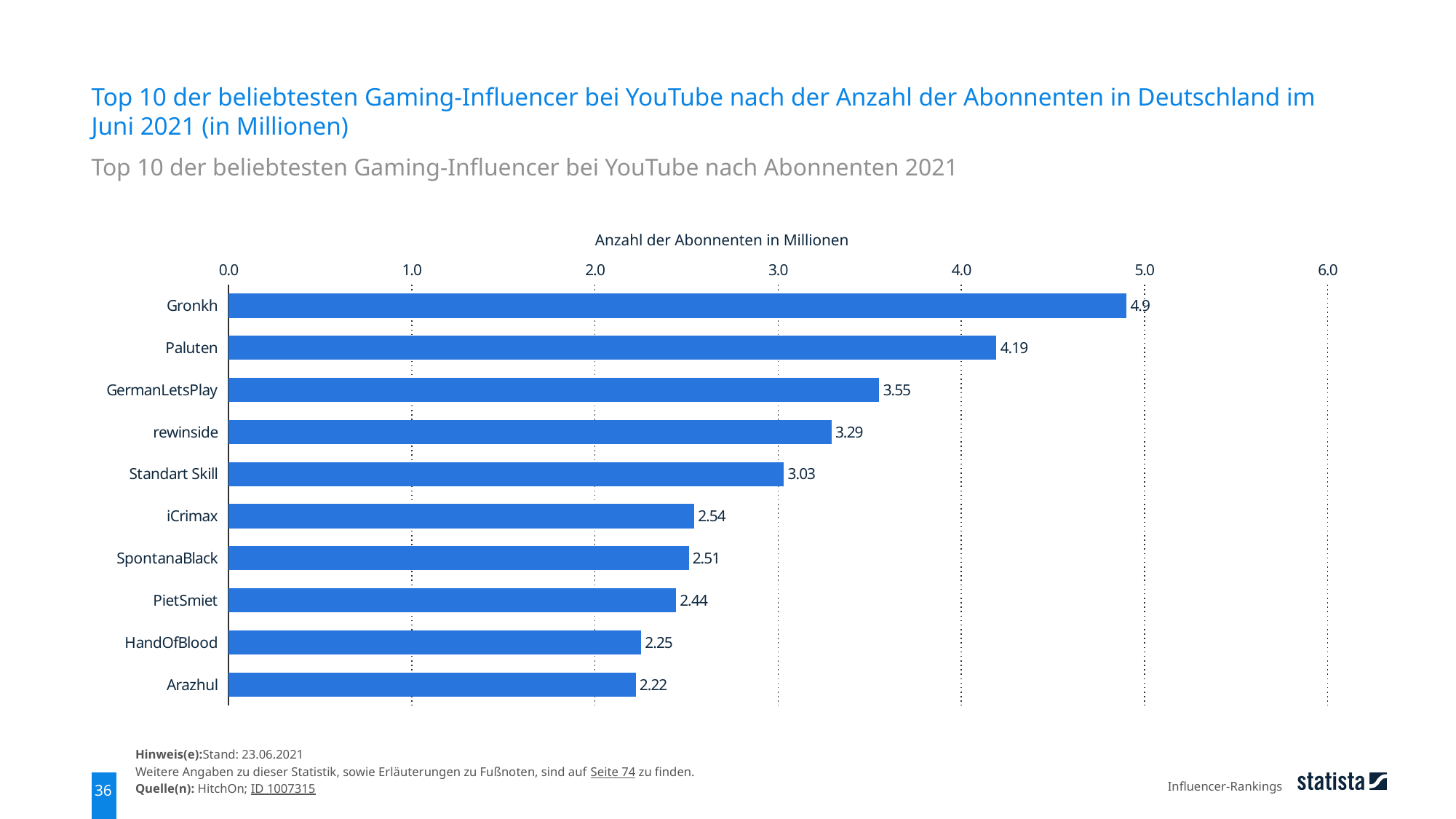
Which has a larger value, rewinside or Standart Skill? rewinside How many subscribers (in millions) does Gronkh have? 4.9 What is the value shown for PietSmiet? 2.44 How many gaming influencers are shown in the chart? 10 What is the difference between the values for HandOfBlood and Arazhul? 0.03 What is the value shown for Standart Skill? 3.03 What kind of chart is shown on the slide? bar chart What is the label of the horizontal axis? Anzahl der Abonnenten in Millionen Is the value for GermanLetsPlay greater or less than 3.0? greater What is the difference between the values for Paluten and GermanLetsPlay? 0.64 Which gaming influencer has the lowest number of subscribers? Arazhul Which gaming influencer has the highest number of subscribers? Gronkh